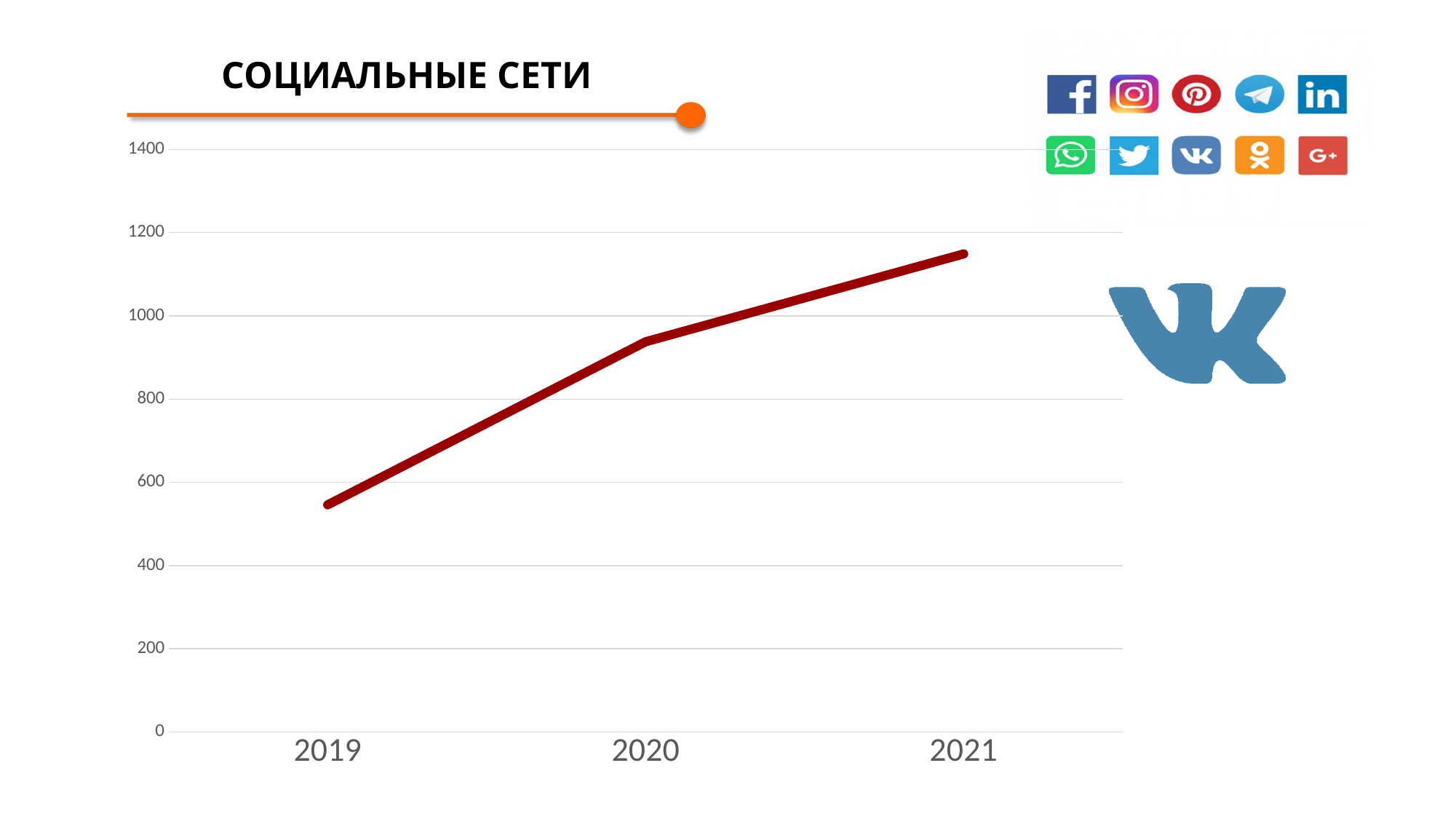
Is the value for 2021 greater or less than 1200? less Which year has the highest value on the chart? 2021 Which year has the lowest value on the chart? 2019 Is the value for 2019 greater or less than 600? less Which is larger, the value for 2020 or the value for 2019? 2020 Do the values on the chart rise or fall from 2019 to 2021? rise What kind of chart is shown on the slide? line chart Is the value for 2020 greater or less than 800? greater How many years are plotted along the x axis of the chart? 3 What is the title shown above the chart on the slide? СОЦИАЛЬНЫЕ СЕТИ